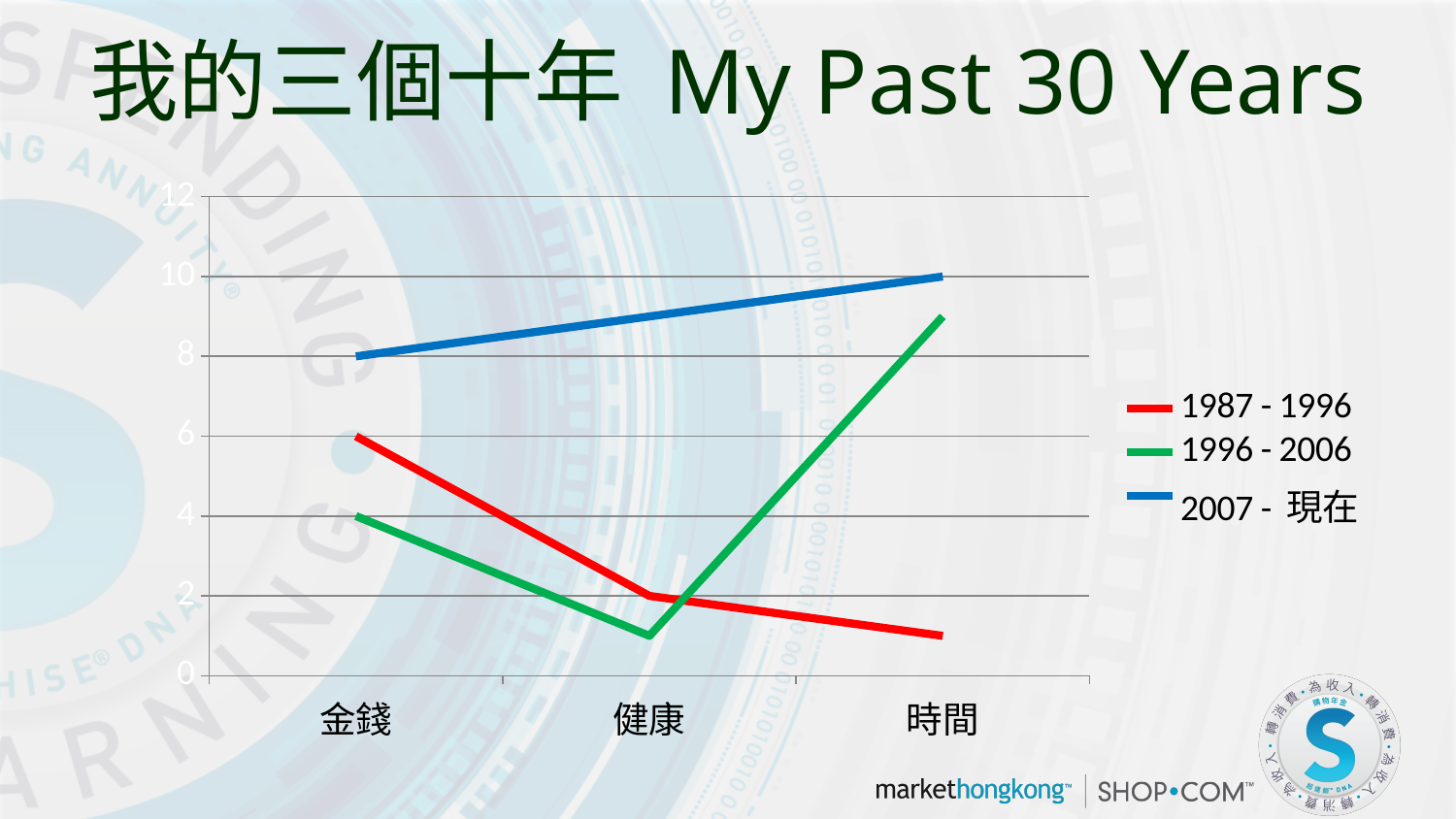
How many series does the legend list? 3 Is the value of the 1996 - 2006 series at 時間 greater or less than 8? greater What is the value of the 1987 - 1996 series at 金錢? 6 What is the value of the 1996 - 2006 series at 金錢? 4 How many categories are shown on the x axis? 3 What is the difference between the 1987 - 1996 values at 金錢 and 健康? 4 What is the value of the 2007 - 現在 series at 金錢? 8 Does the 2007 - 現在 series rise or fall from 金錢 to 時間? rise For the 1987 - 1996 series, which category has the highest value? 金錢 What is the value of the 2007 - 現在 series at 時間? 10 What kind of chart is shown on the slide? line chart Is the value of the 1996 - 2006 series at 健康 greater or less than 2? less